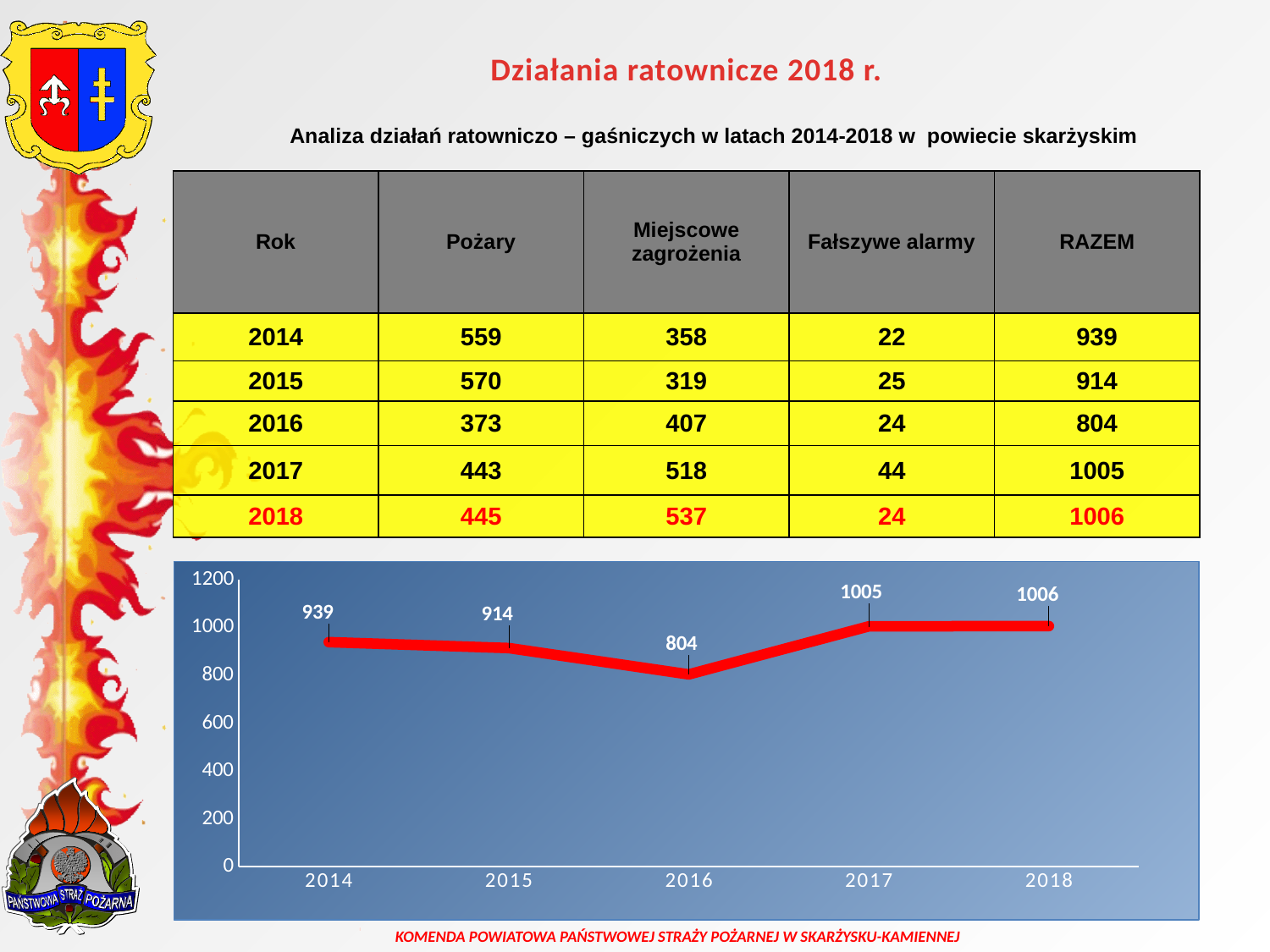
How many years are plotted on the line chart? 5 Is the value for 2016 on the line chart greater or less than 1000? less What is the value plotted for 2016 on the line chart? 804 What is the difference between the values for 2014 and 2015 on the line chart? 25 Which year has the lowest value on the line chart? 2016 Which is larger on the line chart, the value for 2014 or the value for 2015? 2014 What kind of chart is shown on the slide? line chart What is the value plotted for 2014 on the line chart? 939 What colour is the line on the chart? red What is the value plotted for 2018 on the line chart? 1006 Does the value on the line chart rise or fall from 2016 to 2017? rise What is the difference between the values for 2017 and 2016 on the line chart? 201